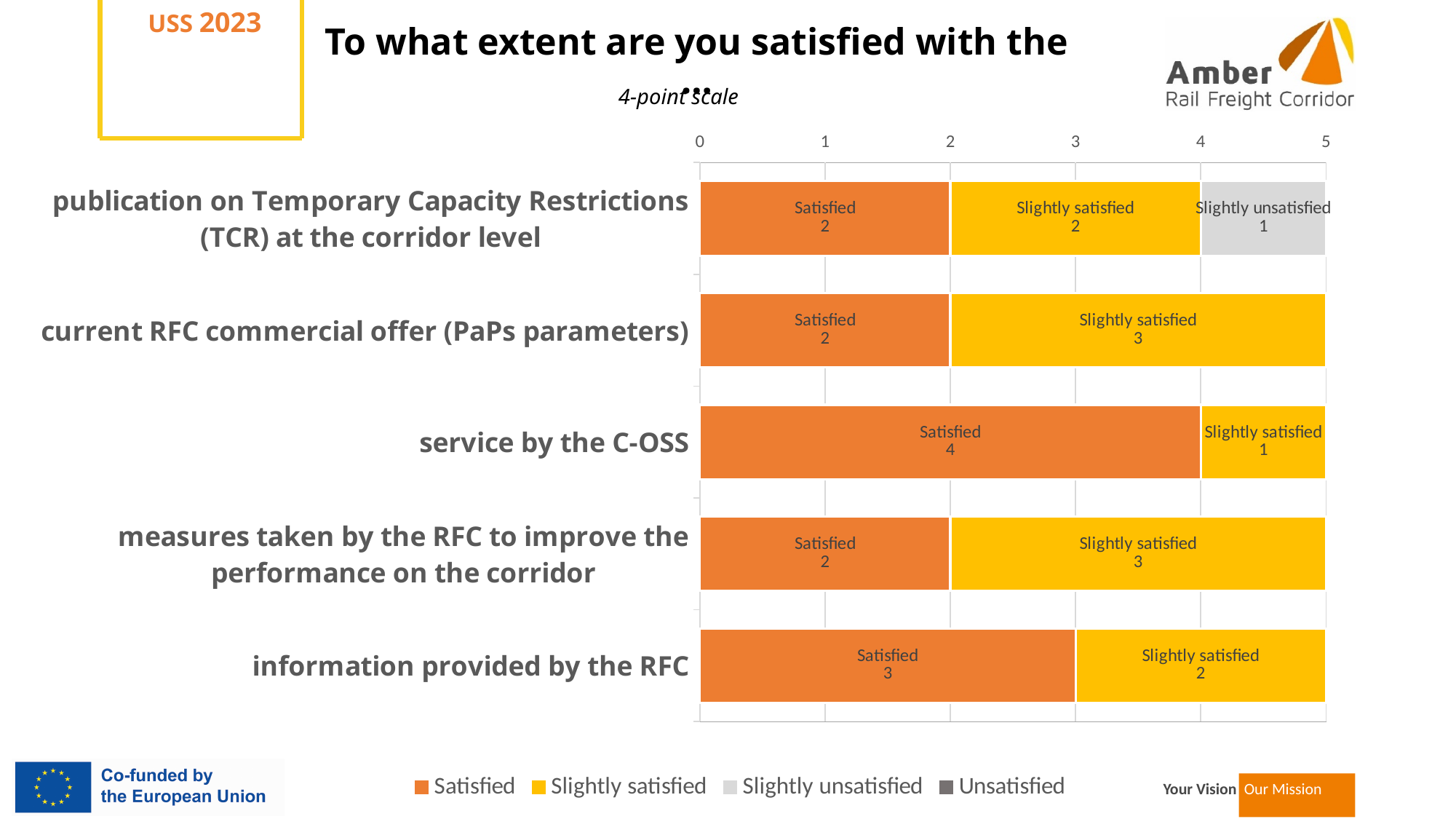
What is the Slightly satisfied value for 'current RFC commercial offer (PaPs parameters)'? 3 How many categories are plotted on the chart? 5 What is the total of the stacked bar for 'publication on Temporary Capacity Restrictions (TCR) at the corridor level'? 5 What kind of chart is shown on the slide? Stacked bar chart Which category has the highest Satisfied value? service by the C-OSS What is the Satisfied value for 'information provided by the RFC'? 3 What is the difference between the Satisfied value for 'service by the C-OSS' and the Satisfied value for 'information provided by the RFC'? 1 What is the Satisfied value for 'service by the C-OSS'? 4 What is the Slightly unsatisfied value for 'publication on Temporary Capacity Restrictions (TCR) at the corridor level'? 1 How many series does the legend list? 4 Which category has the lowest Slightly satisfied value? service by the C-OSS